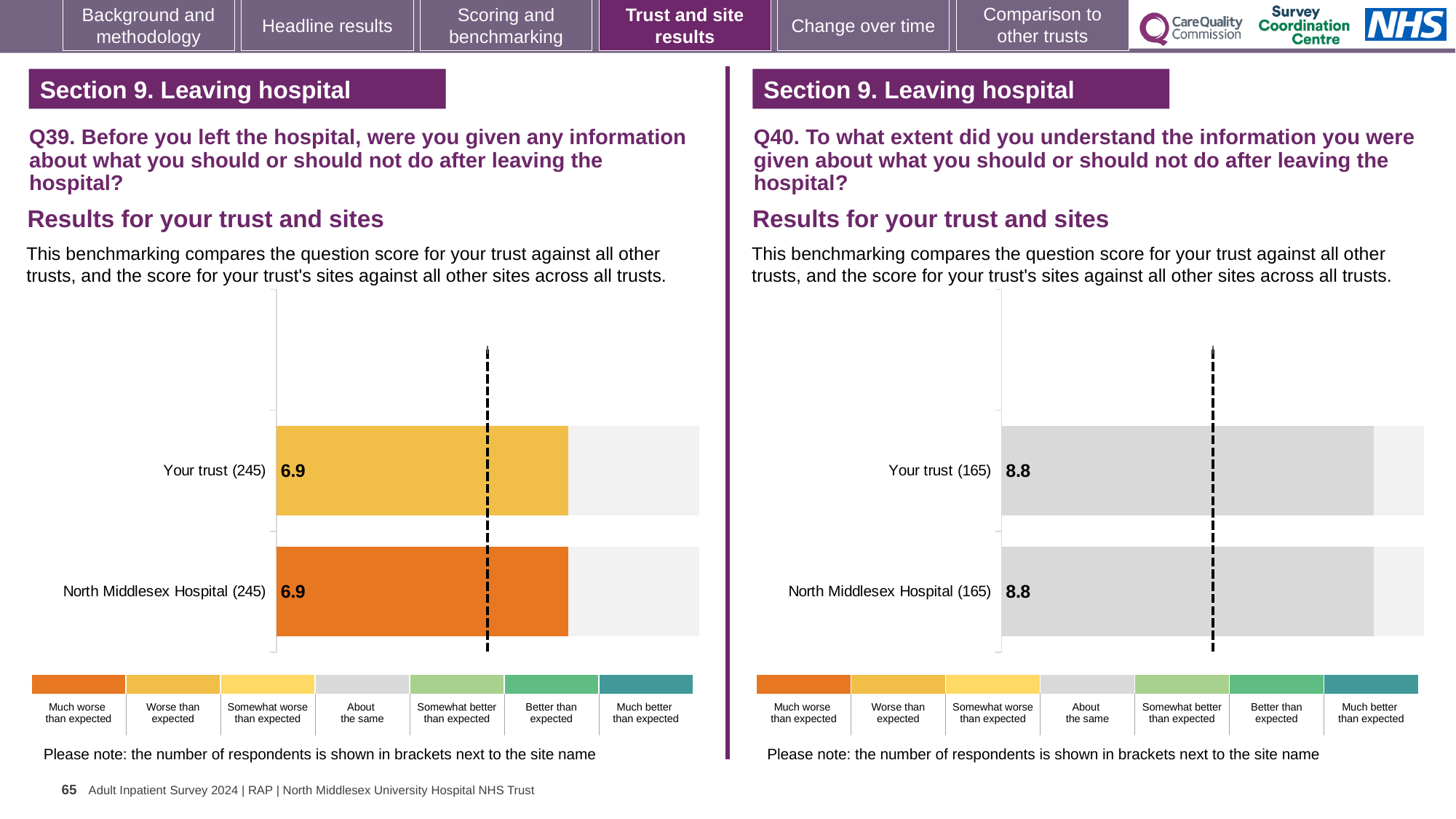
How many respondents are shown in brackets for Your trust in the Q40 chart on the right? 165 How many bars are plotted in the Q39 chart on the left? 2 In the Q40 chart on the right, what is the score for Your trust? 8.8 In the Q39 chart on the left, what is the score for Your trust? 6.9 In the Q40 chart on the right, what is the score for North Middlesex Hospital? 8.8 In the Q40 chart on the right, what is the difference between the score for Your trust and the score for North Middlesex Hospital? 0 How many bars are plotted in the Q40 chart on the right? 2 How many benchmark categories does the colour key below the Q39 chart on the left list? 7 What kind of chart is the Q39 chart on the left? Bar chart In the Q39 chart on the left, what is the difference between the score for Your trust and the score for North Middlesex Hospital? 0 In the Q39 chart on the left, what is the score for North Middlesex Hospital? 6.9